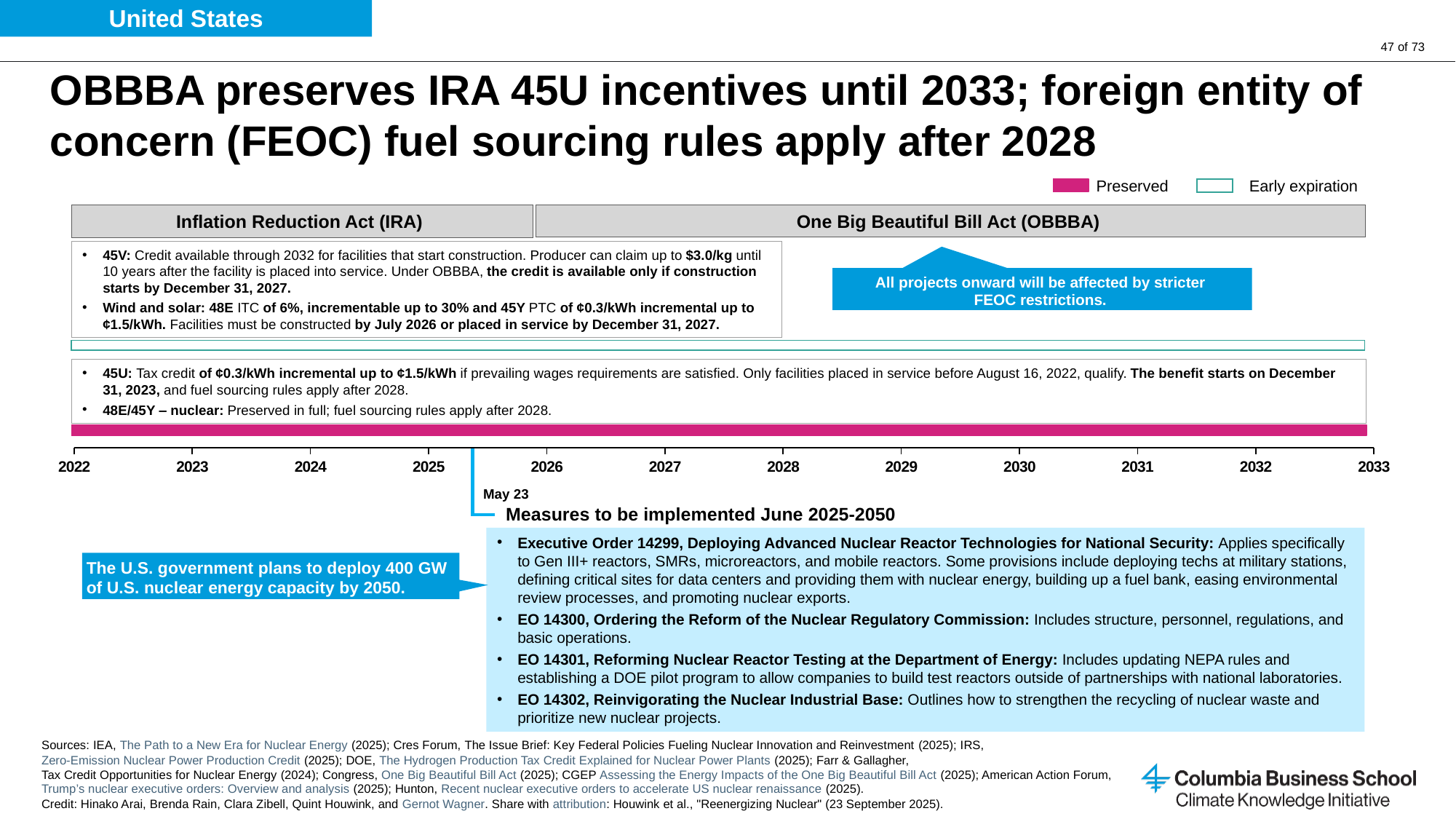
What is the last year shown on the timeline axis? 2033 What kind of chart is shown on the slide? Timeline Which legend entry is represented by the outlined (unfilled) bar on the timeline? Early expiration Which legend entry is represented by the filled magenta bar on the timeline? Preserved What date is marked with a vertical tick on the timeline between 2025 and 2026? May 23 How many entries does the legend of the timeline list? 2 What is the first year shown on the timeline axis? 2022 Until which year does the 'Preserved' bar on the timeline extend? 2033 Which incentives does the 'Preserved' bar on the timeline correspond to: 45U and 48E/45Y nuclear, or 45V and wind and solar? 45U and 48E/45Y nuclear How many year labels appear along the timeline axis? 12